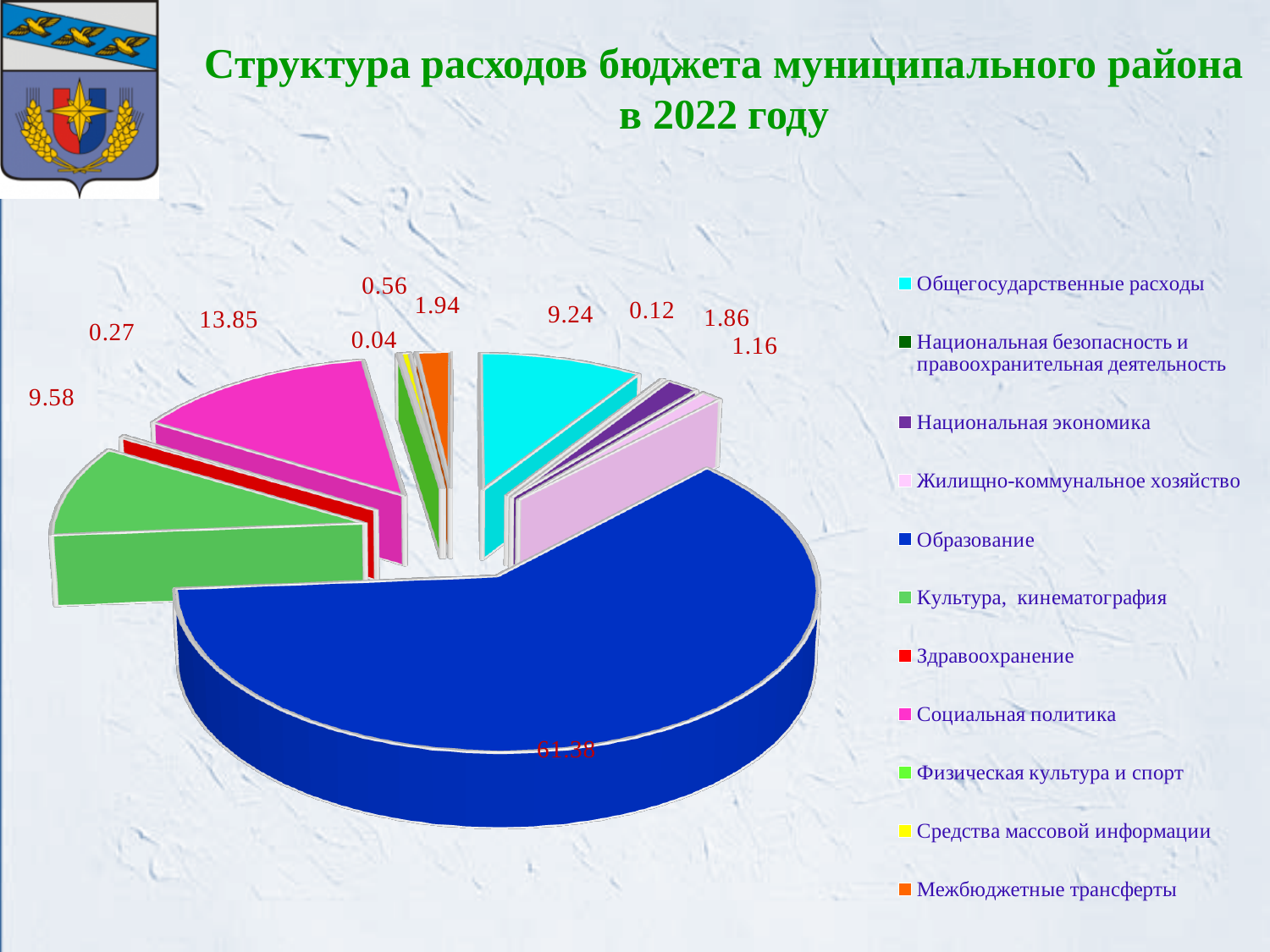
What type of chart is shown on the slide? pie chart What is the value for Общегосударственные расходы? 9.24 Which category has the largest share of the pie? Образование What is the value for Национальная экономика? 1.86 What is the value for Культура, кинематография? 9.58 What is the difference between the values for Образование and Социальная политика? 47.53 How many categories does the legend list? 11 What is the value for Образование? 61.38 What is the value for Социальная политика? 13.85 What is the value for Здравоохранение? 0.27 Which is larger: the value for Культура, кинематография or the value for Общегосударственные расходы? Культура, кинематография What is the value for Жилищно-коммунальное хозяйство? 1.16